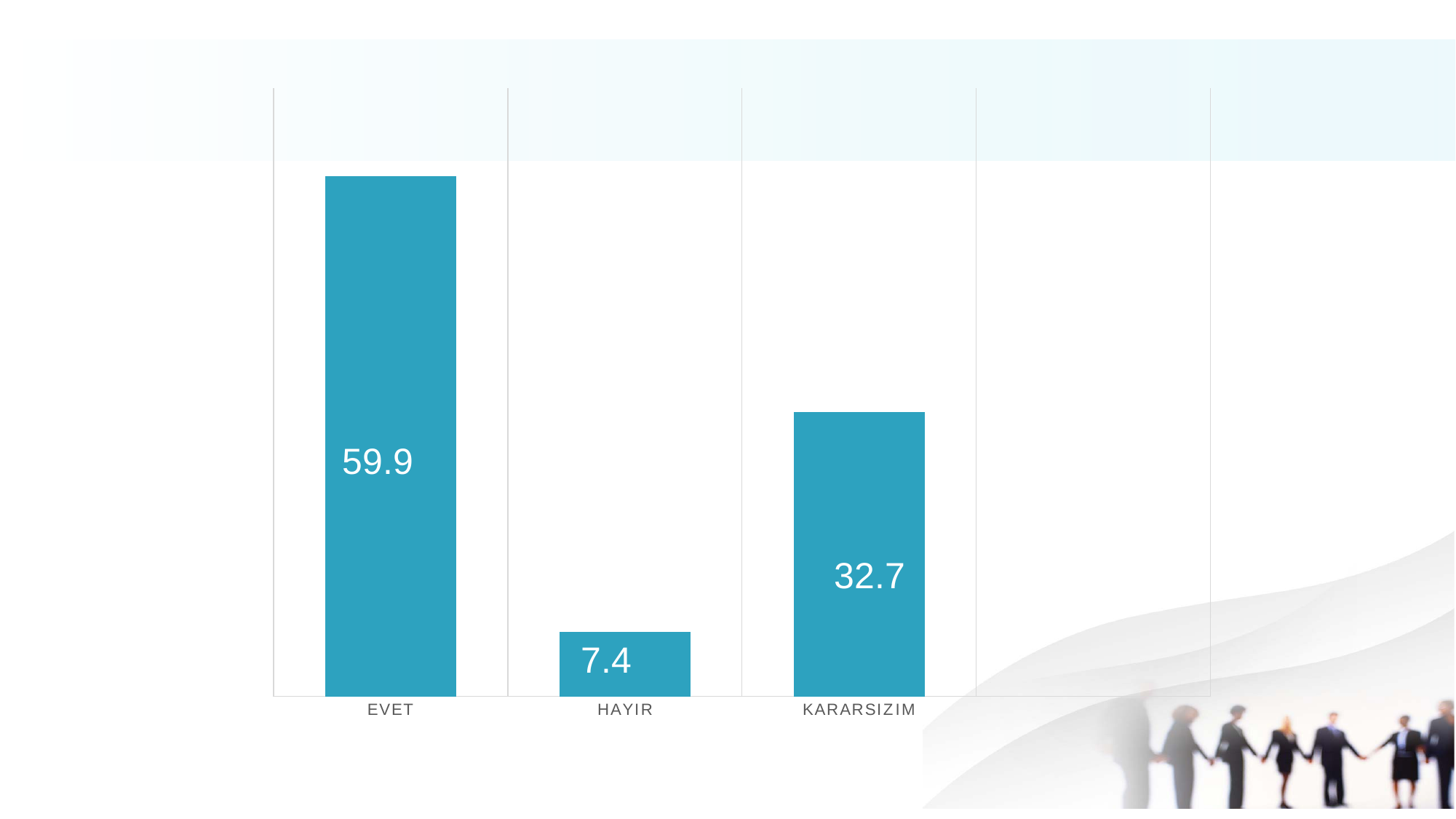
What is the value for KARARSIZIM? 32.7 What kind of chart is shown on the slide? Bar chart What is the total of the three values shown in the chart? 100 What is the difference between the values for EVET and KARARSIZIM? 27.2 What is the value for EVET? 59.9 Which category has the highest value? EVET How many categories are shown in the chart? 3 What colour are the bars in the chart? Teal blue What is the value for HAYIR? 7.4 Which category has the lowest value? HAYIR Which is larger, the value for HAYIR or the value for KARARSIZIM? KARARSIZIM What is the difference between the values for KARARSIZIM and HAYIR? 25.3